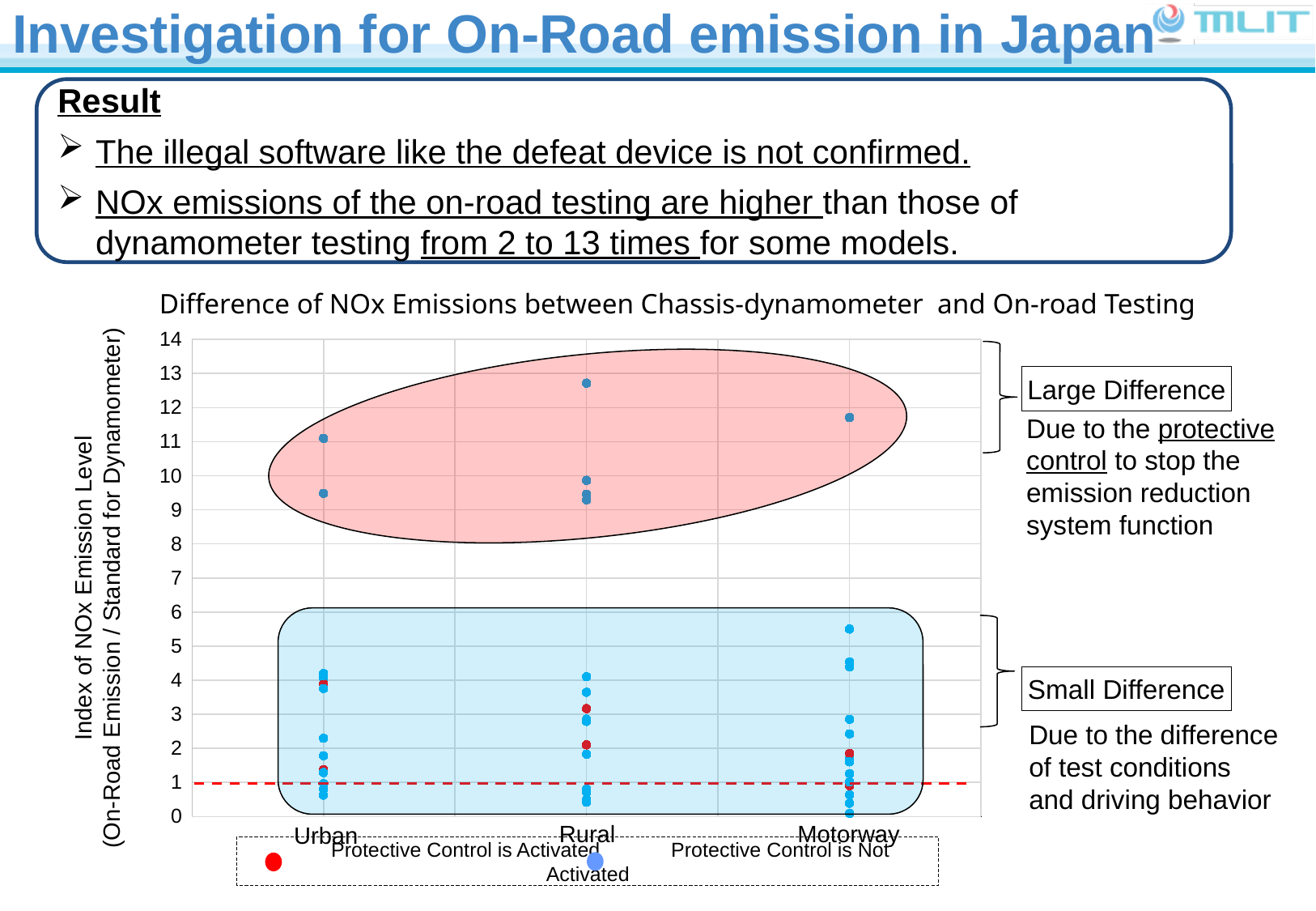
What is the title of the chart? Difference of NOx Emissions between Chassis-dynamometer and On-road Testing Is the highest value for Motorway greater or less than 11? greater Is the lowest value for Motorway greater or less than 1? less Is the highest value for Rural greater or less than 12? greater At what y-axis value is the red dashed horizontal line drawn? 1 Which category contains the highest plotted point in the chart? Rural Which colour marks the series 'Protective Control is Activated' in the legend? red Which is larger, the highest point for Rural or the highest point for Urban? Rural How many categories are shown on the x axis of the chart? 3 What kind of chart is shown on the slide? scatter chart How many series does the chart legend list? 2